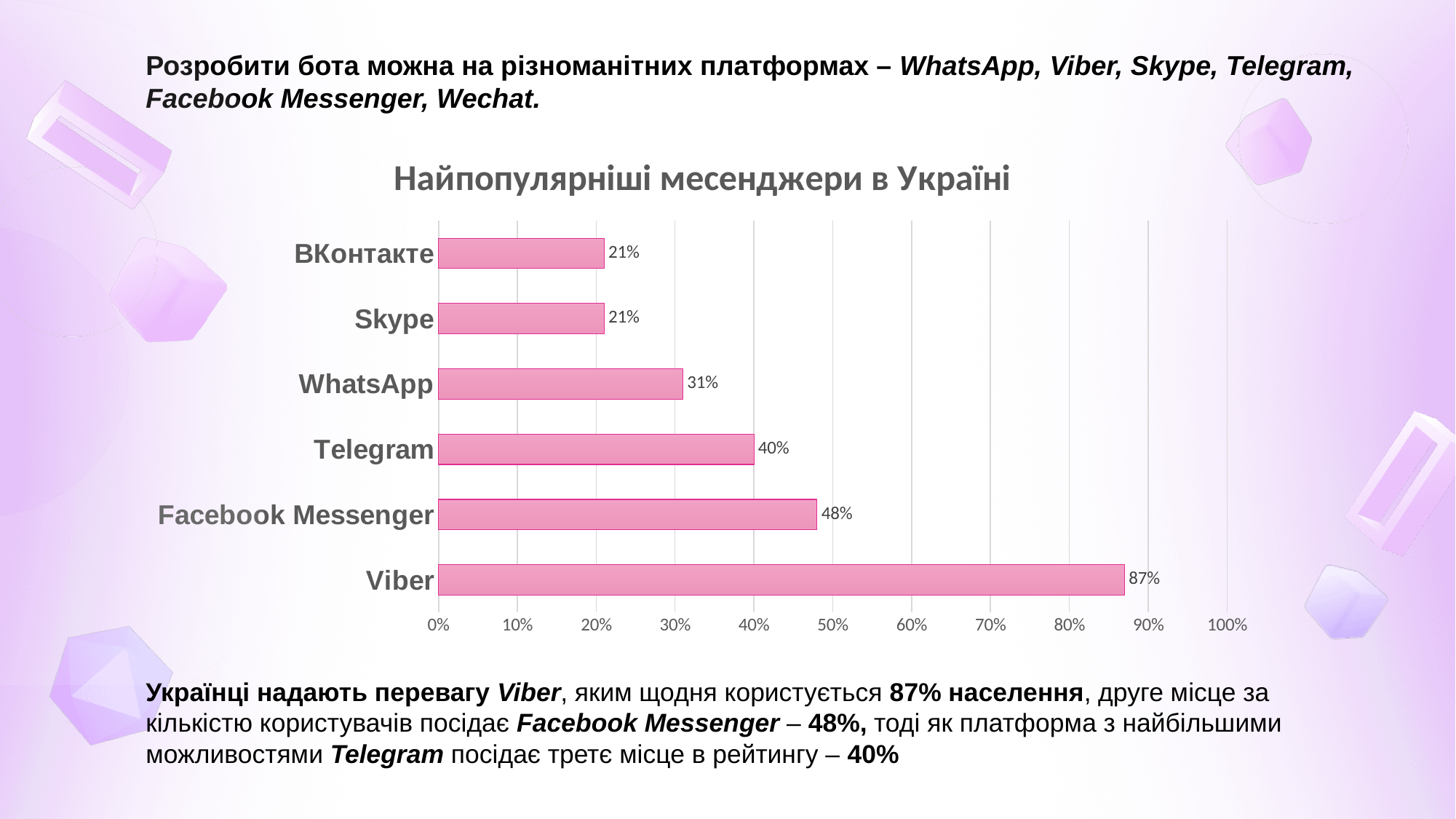
What is the value for Viber? 87% What is the value for Skype? 21% What is the title of the chart? Найпопулярніші месенджери в Україні What is the value for Facebook Messenger? 48% What is the value for Telegram? 40% What kind of chart is shown on the slide? Bar chart What is the difference between the values for Telegram and WhatsApp? 9% Which has a larger value, Telegram or WhatsApp? Telegram How many messengers are shown in the chart? 6 What is the value for WhatsApp? 31% What is the difference between the values for Viber and Facebook Messenger? 39% Which messenger has the highest value? Viber